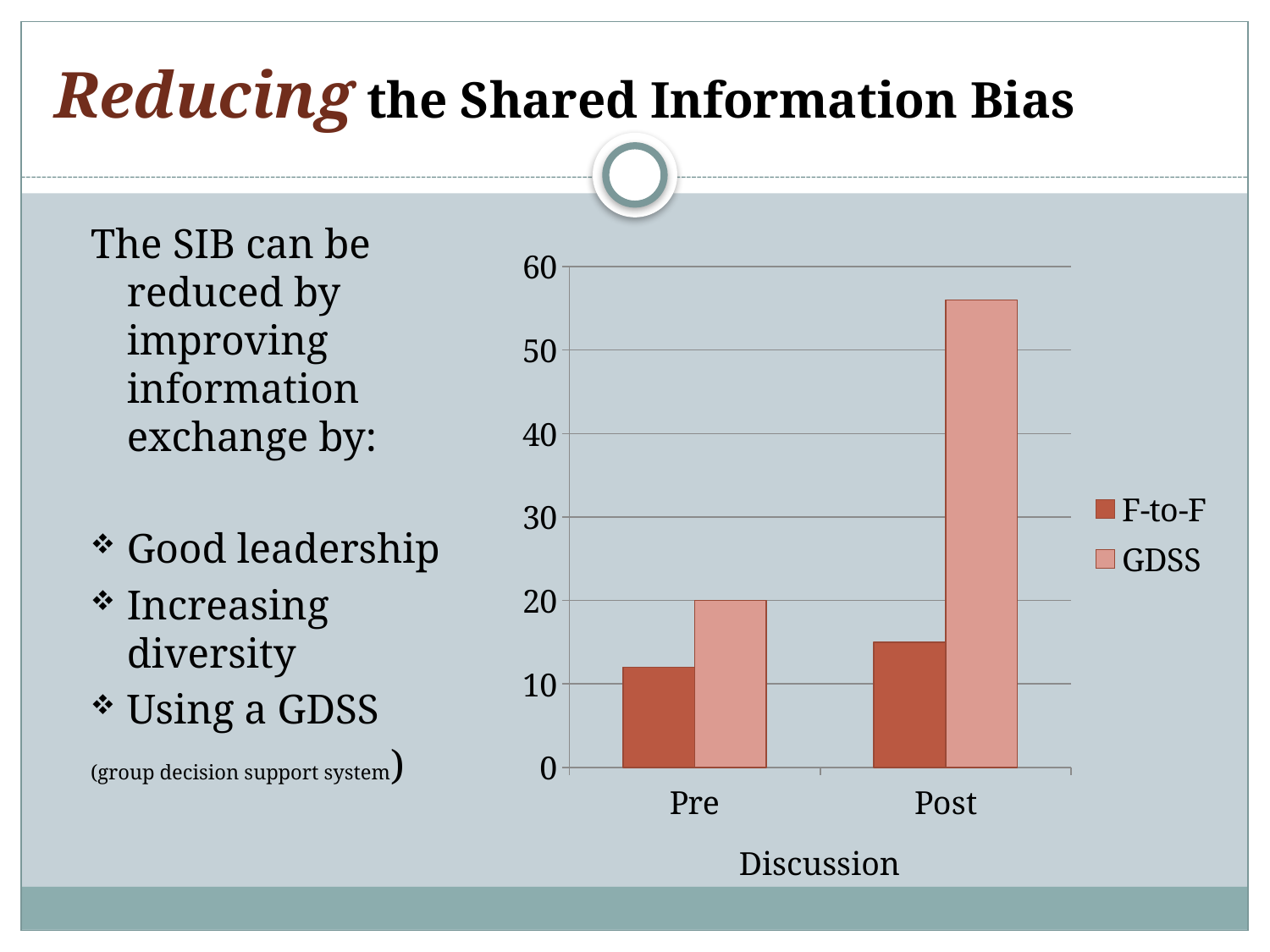
For the Post category, which series has the larger value, F-to-F or GDSS? GDSS What kind of chart is shown on the slide? bar chart Is the GDSS value for Post greater or less than 50? greater What is the x-axis title of the chart? Discussion How many series does the chart legend list? 2 Is the F-to-F value for Post greater or less than 10? greater Which series is shown in the darker red colour in the chart? F-to-F Which series has the highest bar in the chart? GDSS Is the F-to-F value for Pre greater or less than 20? less Which bar is the lowest in the chart? F-to-F for Pre How many categories are shown on the x axis of the chart? 2